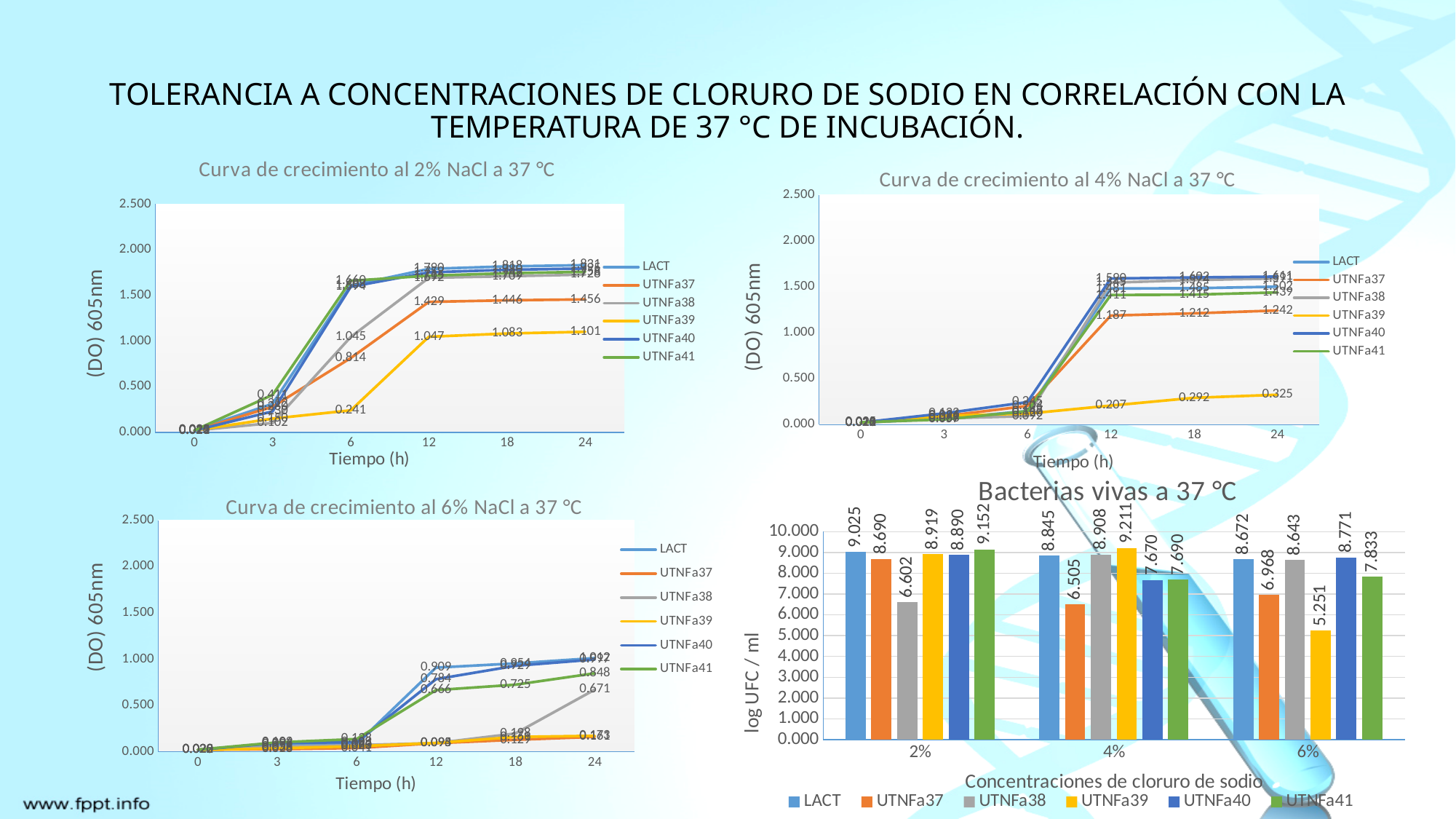
In the 'Curva de crecimiento al 4% NaCl a 37 °C' chart, does the UTNFa37 series rise or fall from 12 h to 24 h? Rise In the 'Bacterias vivas a 37 °C' bar chart, what is the difference between UTNFa41 at 2% and UTNFa41 at 6%? 1.319 In the 'Bacterias vivas a 37 °C' bar chart, what is the value for UTNFa39 at 6%? 5.251 In the 'Curva de crecimiento al 2% NaCl a 37 °C' chart, what is the value for UTNFa37 at 24 h? 1.456 In the 'Curva de crecimiento al 6% NaCl a 37 °C' chart, what is the value for UTNFa41 at 12 h? 0.666 In the 'Bacterias vivas a 37 °C' bar chart, which series has the lowest value at 2%? UTNFa38 In the 'Curva de crecimiento al 4% NaCl a 37 °C' chart, what is the value for UTNFa39 at 24 h? 0.325 In the 'Bacterias vivas a 37 °C' bar chart, which is larger: UTNFa37 at 4% or UTNFa37 at 6%? UTNFa37 at 6% What kind of chart is 'Bacterias vivas a 37 °C'? Bar chart In the 'Bacterias vivas a 37 °C' bar chart, what is the value for LACT at 2%? 9.025 In the 'Bacterias vivas a 37 °C' bar chart, which series has the highest value at 4%? UTNFa39 How many series does the legend of the 'Bacterias vivas a 37 °C' chart list? 6